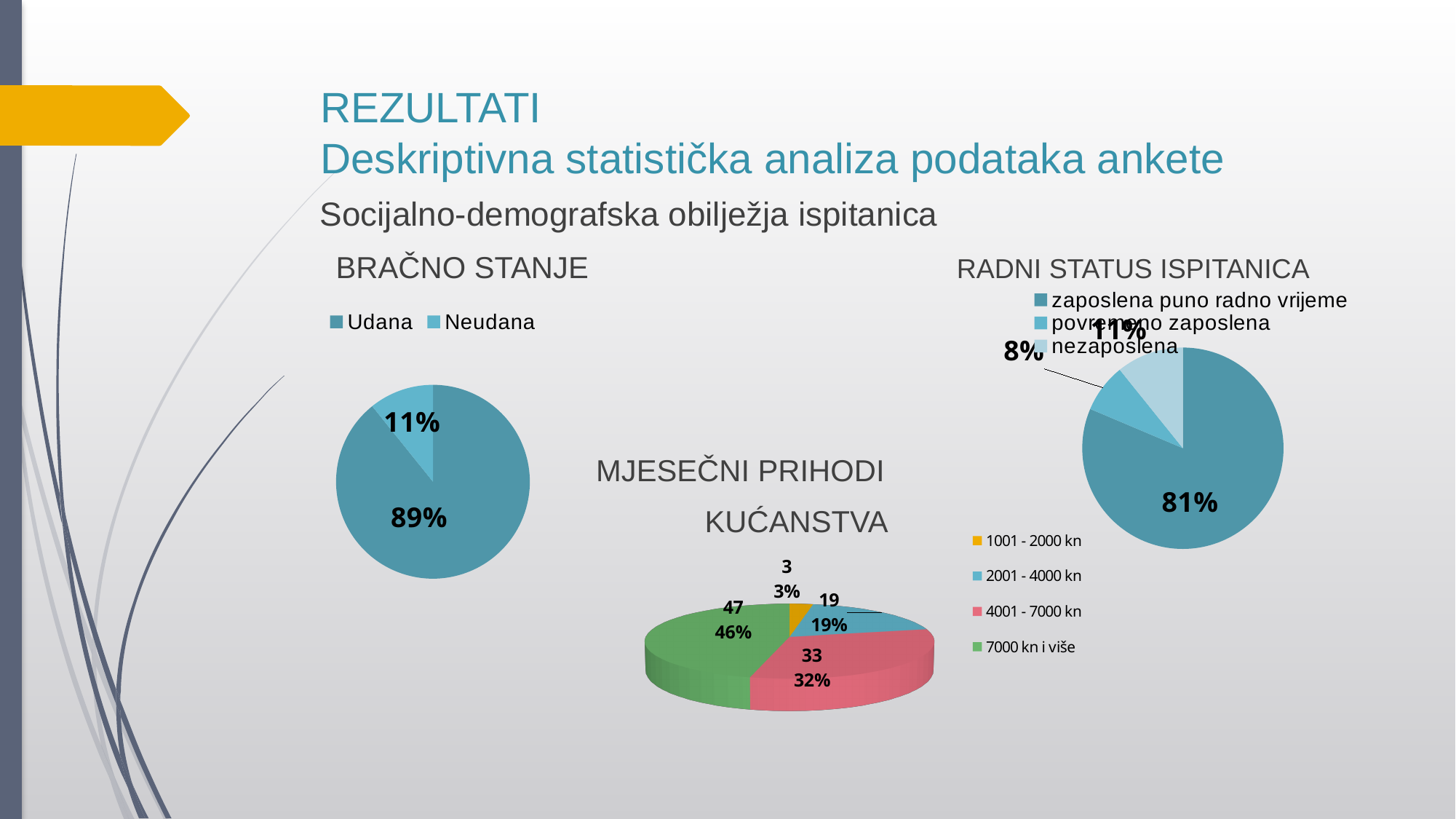
In the BRAČNO STANJE pie chart, what percentage is shown for Neudana? 11% How many categories does the legend of the RADNI STATUS ISPITANICA chart list? 3 In the MJESEČNI PRIHODI KUĆANSTVA chart, which is larger: 2001 - 4000 kn or 4001 - 7000 kn? 4001 - 7000 kn In the MJESEČNI PRIHODI KUĆANSTVA chart, what count is shown for 7000 kn i više? 47 In the MJESEČNI PRIHODI KUĆANSTVA chart, what percentage is shown for 4001 - 7000 kn? 32% In the RADNI STATUS ISPITANICA pie chart, what percentage is shown for zaposlena puno radno vrijeme? 81% What type of chart is used for MJESEČNI PRIHODI KUĆANSTVA? Pie chart In the BRAČNO STANJE chart, what is the difference in percentage points between Udana and Neudana? 78 In the BRAČNO STANJE pie chart, what percentage is shown for Udana? 89% In the BRAČNO STANJE chart, which category has the larger share? Udana In the MJESEČNI PRIHODI KUĆANSTVA chart, what is the difference between the counts for 7000 kn i više and 2001 - 4000 kn? 28 In the MJESEČNI PRIHODI KUĆANSTVA chart, which category has the smallest share? 1001 - 2000 kn